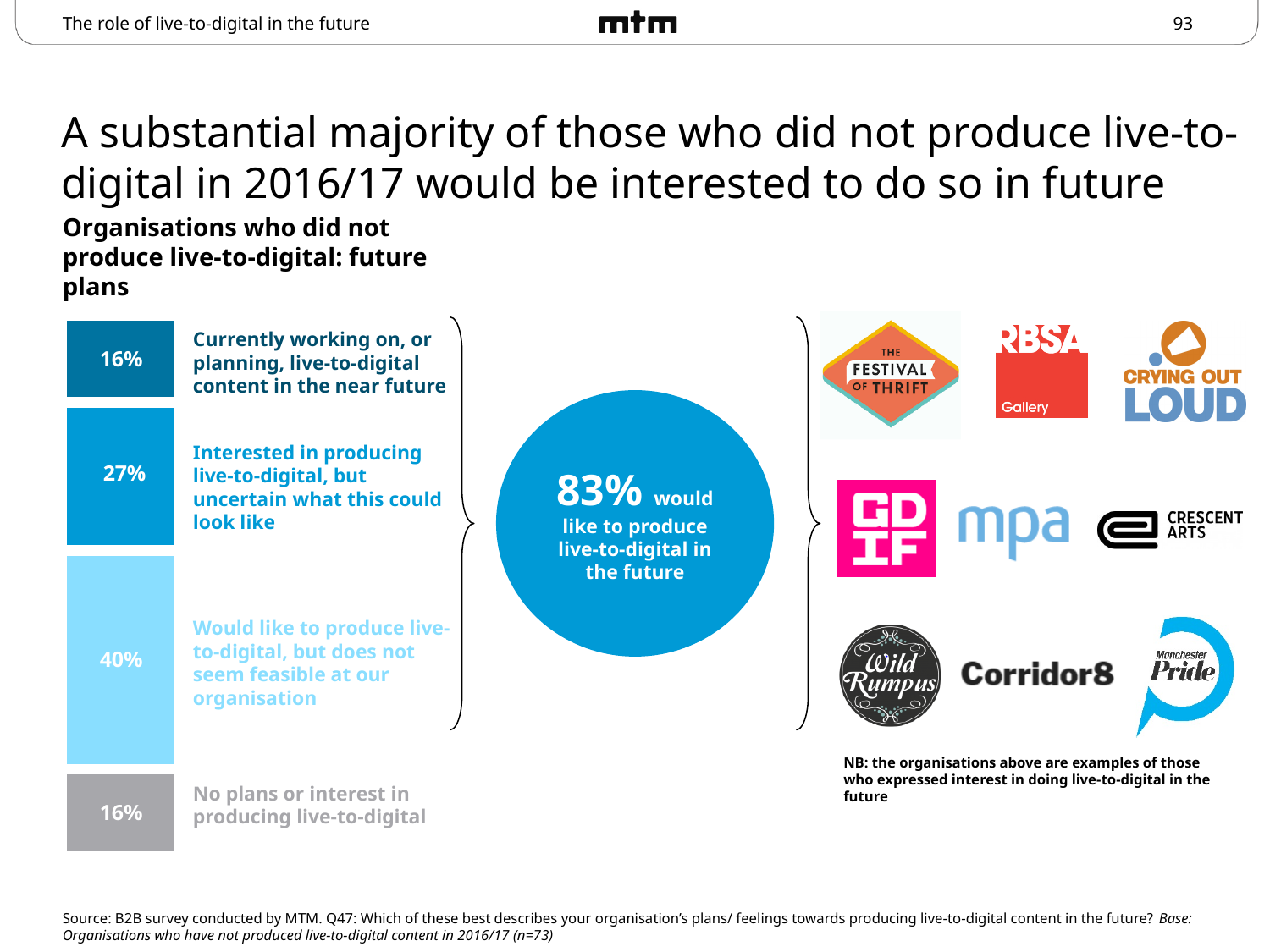
How many categories are shown in the stacked bar? 4 What percentage of organisations would like to produce live-to-digital, but it does not seem feasible at their organisation? 40% What kind of chart is used to show the organisations' future plans? Stacked bar chart What is the difference between the share who would like to produce live-to-digital but find it not feasible and the share who are interested but uncertain? 13% What is the title of the chart on the left of the slide? Organisations who did not produce live-to-digital: future plans What is the combined percentage of the three categories that would like to produce live-to-digital in the future, as shown in the circle? 83% Which is larger: the share interested but uncertain what it could look like, or the share with no plans or interest? Interested in producing live-to-digital, but uncertain what this could look like What percentage of organisations are interested in producing live-to-digital, but uncertain what this could look like? 27% What is the base size (n) for the survey question shown on the slide? 73 Which category has the largest share in the stacked bar? Would like to produce live-to-digital, but does not seem feasible at our organisation What percentage of organisations are currently working on, or planning, live-to-digital content in the near future? 16% What percentage of organisations have no plans or interest in producing live-to-digital? 16%